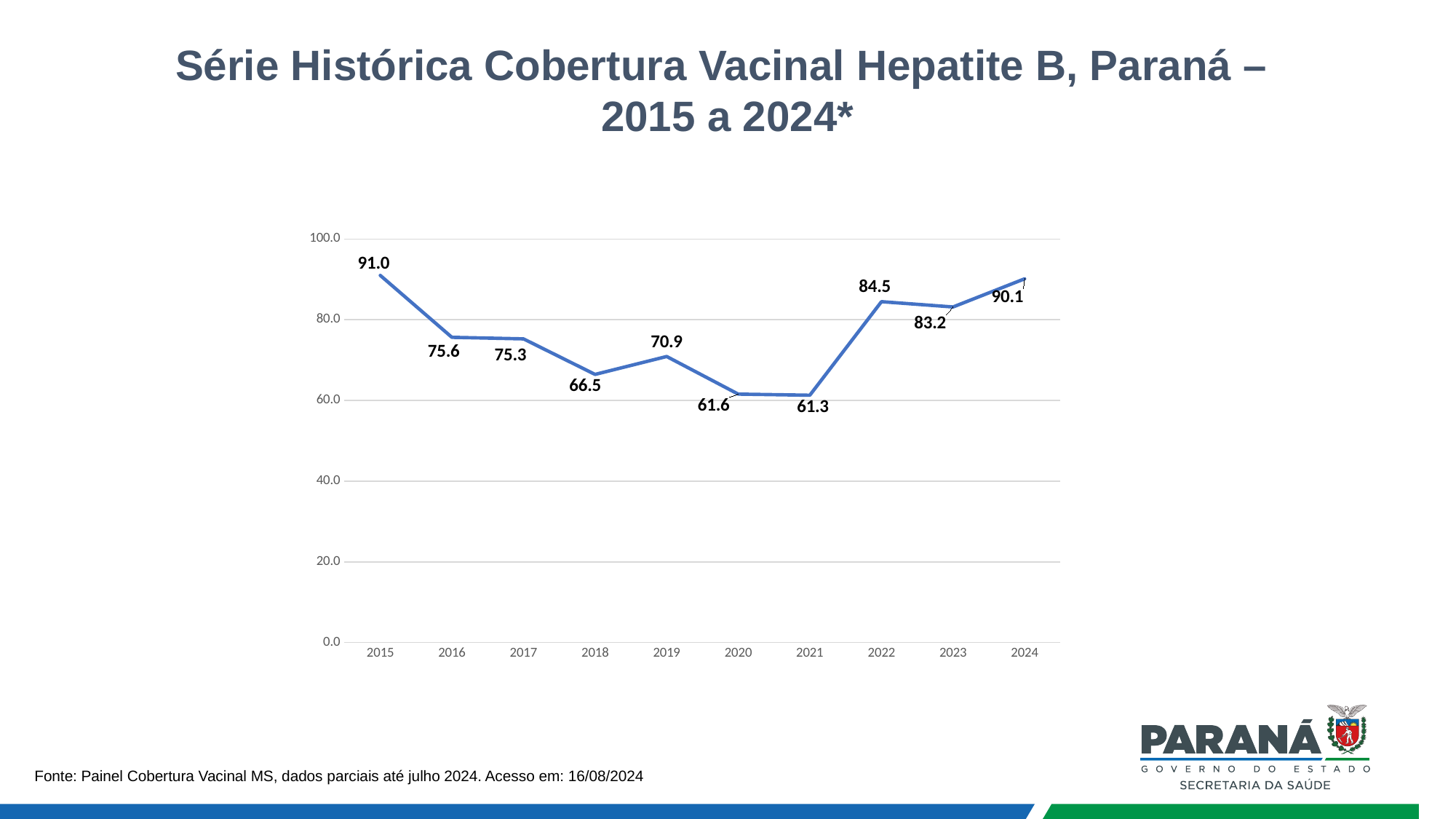
Which is larger, the value for 2019 or the value for 2018? 2019 Which year has the highest value? 2015 How many years are plotted on the x axis? 10 What is the difference between the values for 2022 and 2021? 23.2 Is the value for 2020 greater or less than 80.0? less What kind of chart is shown on the slide? line chart What is the value shown for 2024? 90.1 What is the vaccination coverage value for 2015? 91.0 What is the value shown for 2021? 61.3 What is the difference between the values for 2015 and 2016? 15.4 Do the values rise or fall from 2021 to 2024? rise Which year has the lowest value? 2021